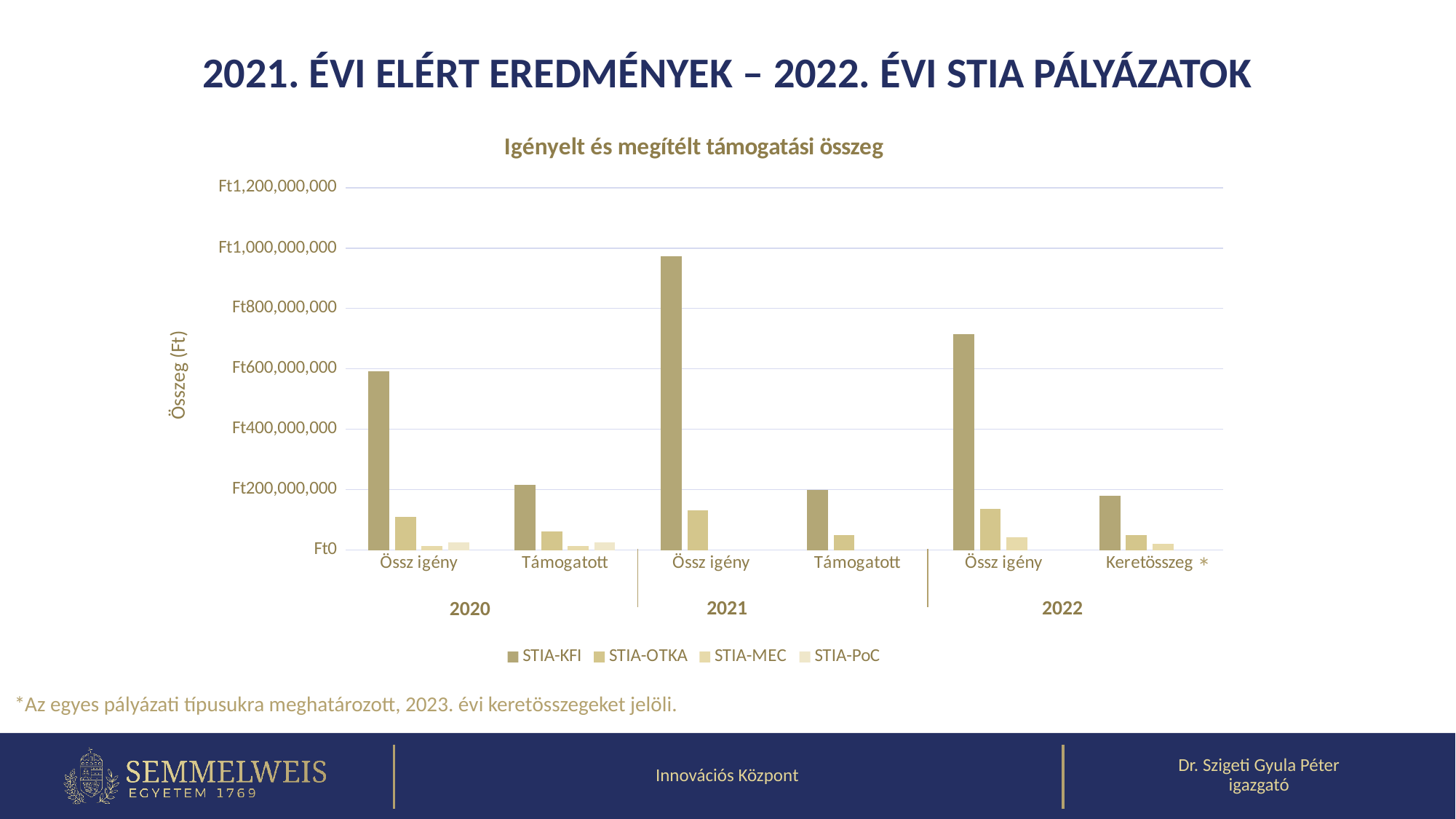
Is the STIA-KFI value for 2021 Össz igény greater or less than Ft800,000,000? greater What is the label of the vertical axis? Összeg (Ft) In which category group is the STIA-KFI bar the tallest? 2021 Össz igény What kind of chart is shown on the slide? bar chart How many series does the legend list? 4 Which is larger: the STIA-KFI value for 2020 Támogatott or the STIA-KFI value for 2022 Keretösszeg? 2020 Támogatott How many category groups are shown along the x axis? 6 Is the STIA-OTKA value for 2021 Össz igény greater or less than Ft200,000,000? less Is the STIA-KFI value for 2022 Össz igény greater or less than Ft600,000,000? greater What is the title of the chart? Igényelt és megítélt támogatási összeg Which series has the tallest bar in every category group? STIA-KFI